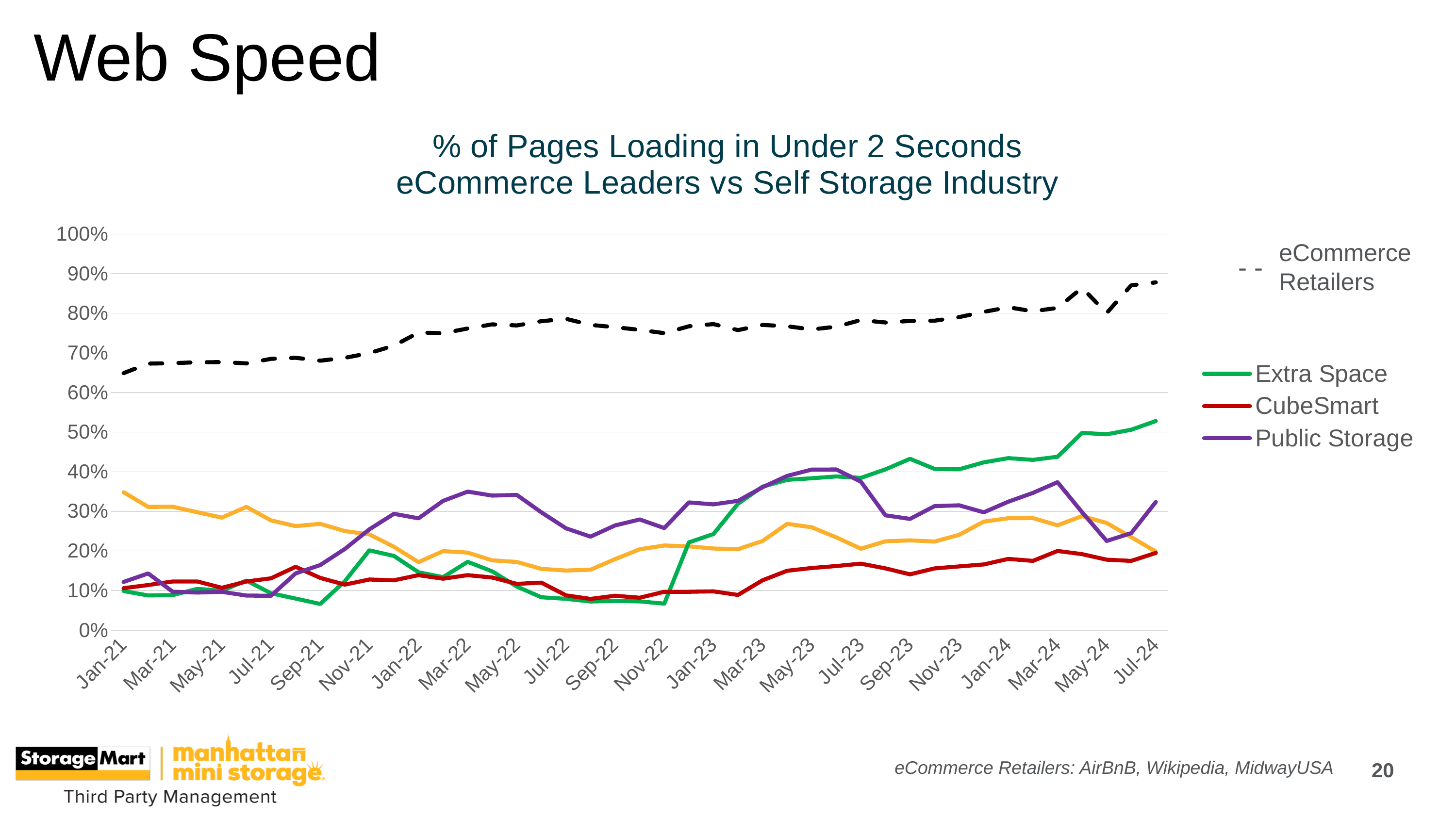
What kind of chart is shown on the slide? line chart At Jul-23, which is larger: Public Storage or CubeSmart? Public Storage Which series has the highest values across the whole period shown? eCommerce Retailers Is the value for CubeSmart at Jul-24 greater or less than 30%? less How many series does the chart's legend list? 4 Is the value for Extra Space at Jul-24 greater or less than 50%? greater Which of the legend series has the lowest value at Jan-23? CubeSmart Which series is drawn with a dashed line? eCommerce Retailers At Jul-24, which is larger: Extra Space or CubeSmart? Extra Space Does the eCommerce Retailers line rise or fall overall from Jan-21 to Jul-24? rise Is the value for Public Storage at Jul-24 greater or less than 40%? less